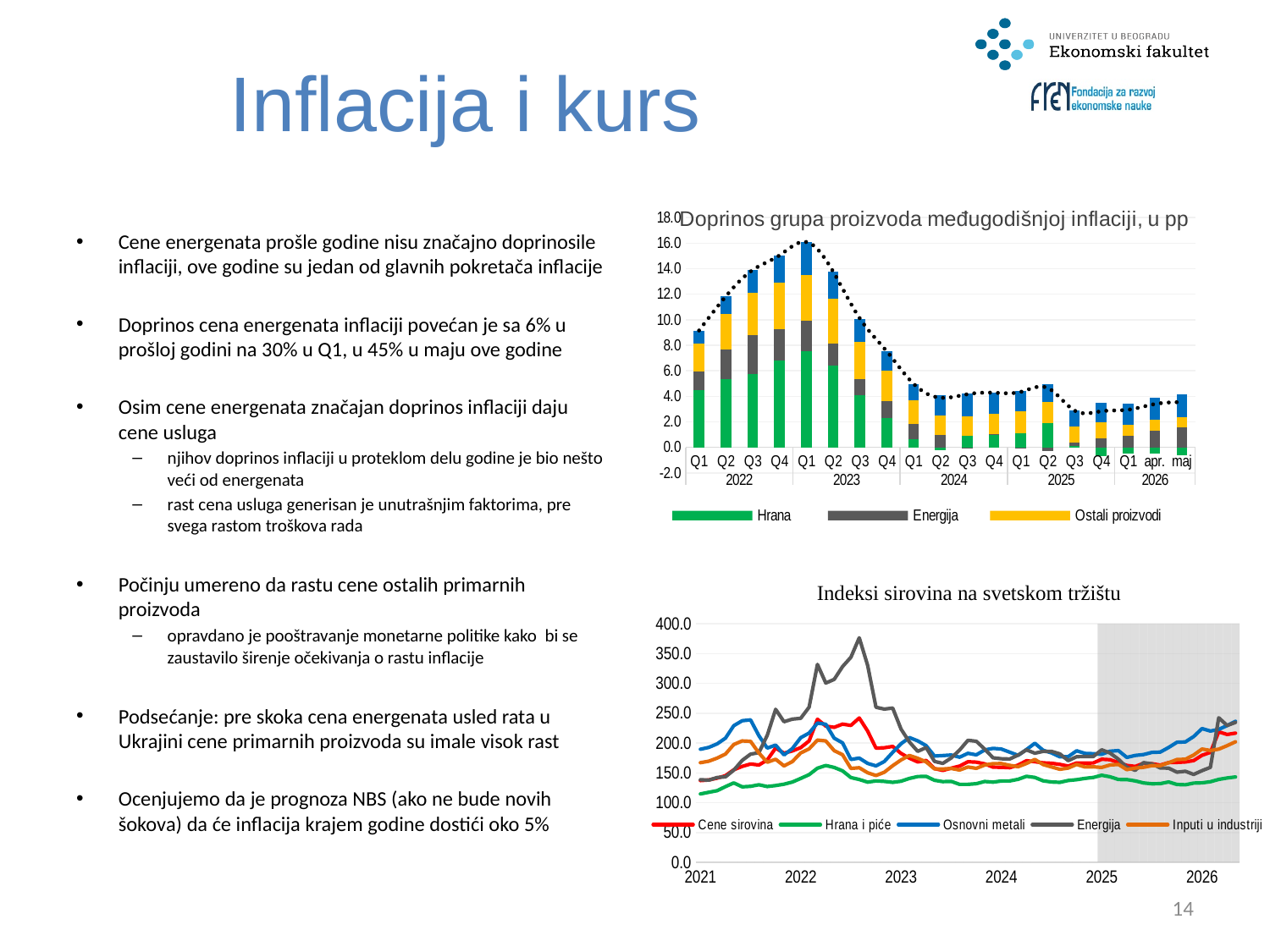
In the top chart 'Doprinos grupa proizvoda međugodišnjoj inflaciji, u pp', which quarter has the highest total bar? Q1 2023 In the bottom chart 'Indeksi sirovina na svetskom tržištu', which series is the lowest line across the whole period? Hrana i piće In the top chart 'Doprinos grupa proizvoda međugodišnjoj inflaciji, u pp', is the total for Q1 2024 greater or less than 8.0? less What kind of chart is the bottom chart titled 'Indeksi sirovina na svetskom tržištu'? line chart In the top chart 'Doprinos grupa proizvoda međugodišnjoj inflaciji, u pp', which series is shown in green? Hrana In the top chart 'Doprinos grupa proizvoda međugodišnjoj inflaciji, u pp', how many series does the legend list? 3 In the top chart 'Doprinos grupa proizvoda međugodišnjoj inflaciji, u pp', do the total bars rise or fall from Q1 2023 to Q1 2024? fall What kind of chart is the top chart titled 'Doprinos grupa proizvoda međugodišnjoj inflaciji, u pp'? stacked bar chart In the top chart 'Doprinos grupa proizvoda međugodišnjoj inflaciji, u pp', is the total for Q1 2023 greater or less than 14.0? greater In the bottom chart 'Indeksi sirovina na svetskom tržištu', how many series does the legend list? 5 In the bottom chart 'Indeksi sirovina na svetskom tržištu', which series reaches the highest peak? Energija In the bottom chart 'Indeksi sirovina na svetskom tržištu', is the peak value of Energija in 2022 greater or less than 350.0? greater